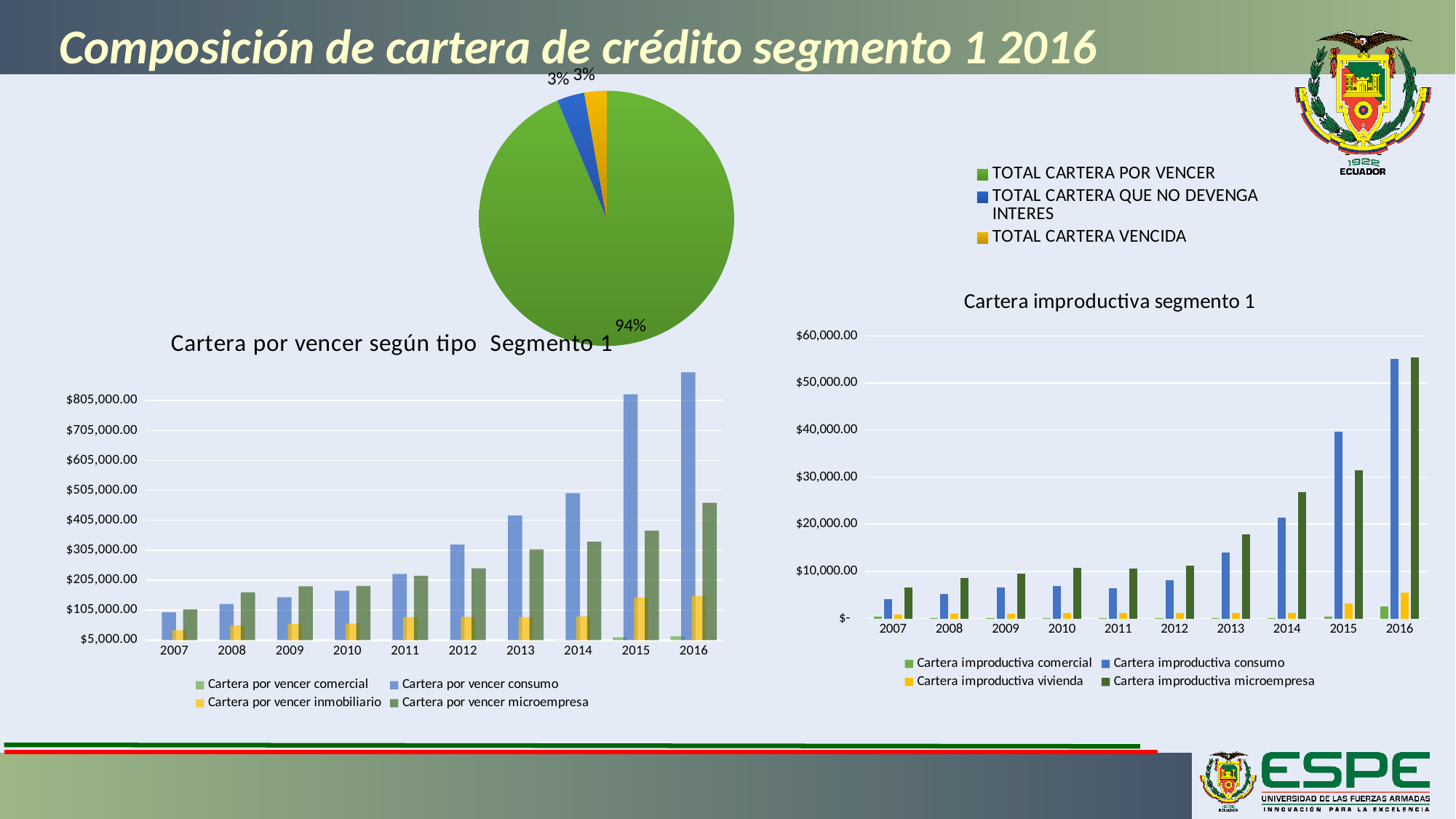
What kind of chart is 'Cartera por vencer según tipo Segmento 1'? bar chart How many series does the legend of 'Cartera por vencer según tipo Segmento 1' list? 4 In 'Cartera por vencer según tipo Segmento 1', is the value for Cartera por vencer consumo in 2015 greater or less than $805,000.00? greater In the pie chart, what share does TOTAL CARTERA VENCIDA have? 3% How many categories does the pie chart's legend list? 3 In the pie chart, which category has the largest slice? TOTAL CARTERA POR VENCER In 'Cartera por vencer según tipo Segmento 1', how many years are shown on the x axis? 10 In the pie chart, what share does TOTAL CARTERA POR VENCER have? 94% In 'Cartera improductiva segmento 1', does Cartera improductiva microempresa rise or fall from 2007 to 2016? rise In 'Cartera improductiva segmento 1', is the value for Cartera improductiva microempresa in 2014 greater or less than $30,000.00? less In 'Cartera improductiva segmento 1', which is larger in 2015: Cartera improductiva consumo or Cartera improductiva microempresa? Cartera improductiva consumo In 'Cartera por vencer según tipo Segmento 1', which year has the highest value for Cartera por vencer consumo? 2016